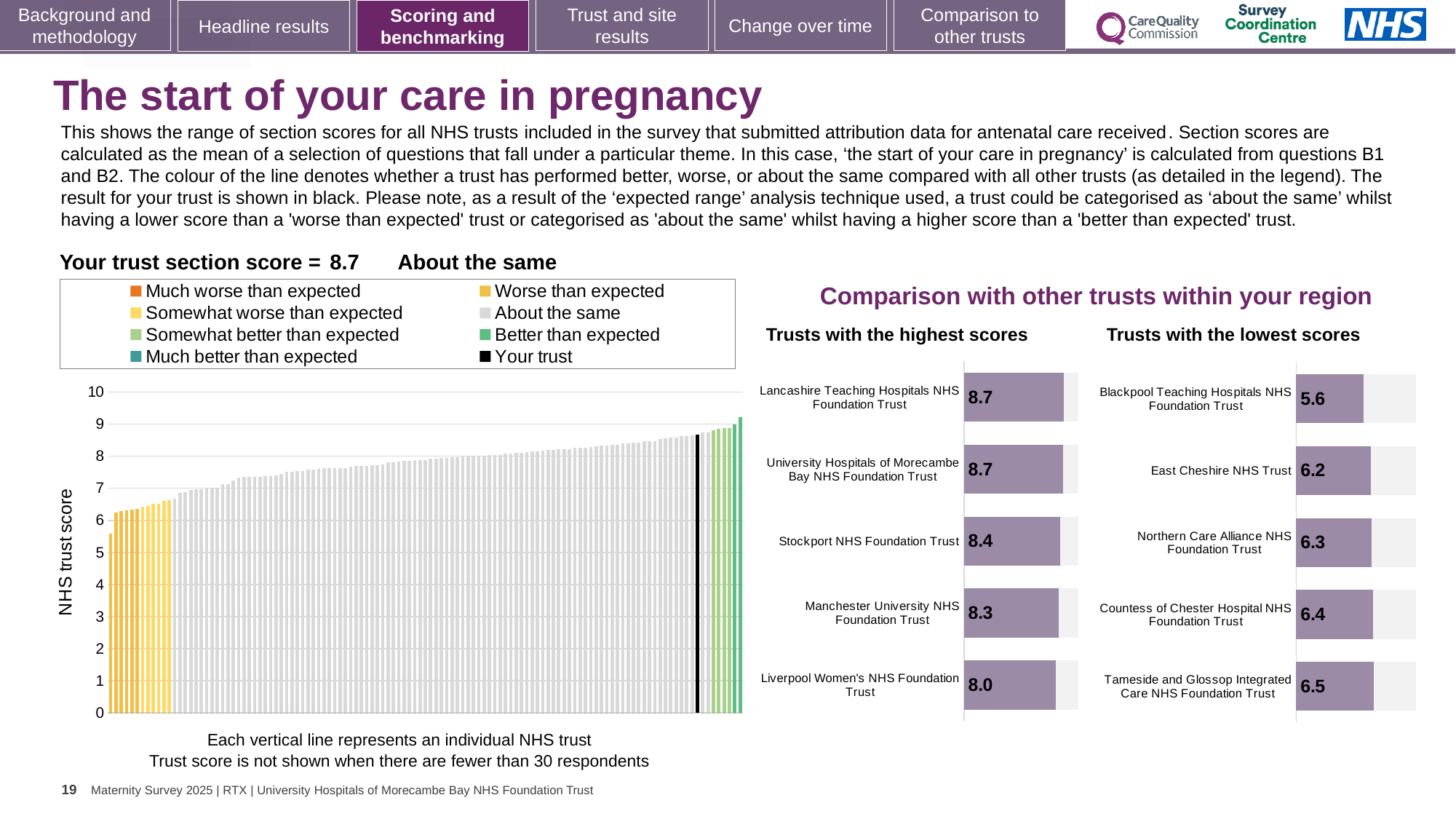
In the 'Trusts with the lowest scores' chart, which has the higher score: Northern Care Alliance NHS Foundation Trust or Countess of Chester Hospital NHS Foundation Trust? Countess of Chester Hospital NHS Foundation Trust In the main chart on the left showing all NHS trust scores, is the value of the black bar (your trust) greater or less than 8? greater How many trusts are shown in the 'Trusts with the highest scores' chart? 5 In the 'Trusts with the lowest scores' chart, what is the score for East Cheshire NHS Trust? 6.2 What kind of chart is the main chart on the left showing NHS trust scores? Bar chart In the 'Trusts with the lowest scores' chart, which trust has the lowest score? Blackpool Teaching Hospitals NHS Foundation Trust In the 'Trusts with the highest scores' chart, what is the difference between the scores of Lancashire Teaching Hospitals NHS Foundation Trust and Liverpool Women's NHS Foundation Trust? 0.7 In the main chart on the left showing all NHS trust scores, is the value of the leftmost (lowest) bar greater or less than 6? less How many entries does the legend of the main chart on the left list? 8 In the 'Trusts with the highest scores' chart, which trust has the lowest score shown? Liverpool Women's NHS Foundation Trust In the 'Trusts with the lowest scores' chart, what is the difference between the scores of Tameside and Glossop Integrated Care NHS Foundation Trust and Blackpool Teaching Hospitals NHS Foundation Trust? 0.9 In the 'Trusts with the highest scores' chart, what is the score for Stockport NHS Foundation Trust? 8.4